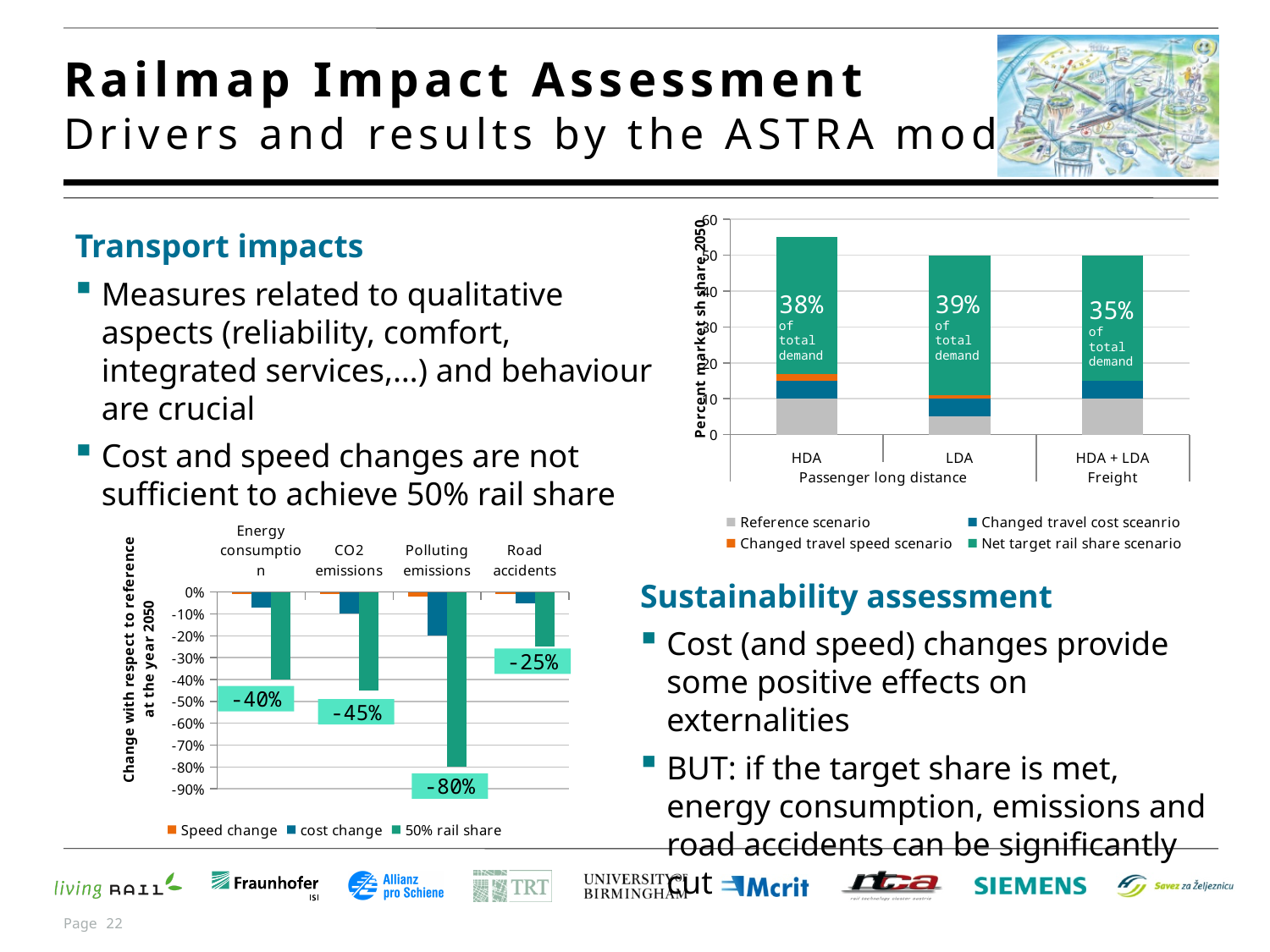
In the top-right market share chart, what share of total demand is labelled on the HDA + LDA Freight bar? 35% In the bottom-left chart, what is the value of the 50% rail share series for CO2 emissions? -45% In the top-right market share chart, what share of total demand is labelled on the LDA bar? 39% In the bottom-left chart, what is the value of the 50% rail share series for Polluting emissions? -80% How many series does the legend of the top-right market share chart list? 4 In the bottom-left chart, which category shows the smallest reduction under the 50% rail share scenario? Road accidents How many series does the legend of the bottom-left chart list? 3 In the bottom-left chart, what is the value of the 50% rail share series for Energy consumption? -40% In the bottom-left chart, what is the value of the 50% rail share series for Road accidents? -25% In the bottom-left chart, what is the difference between the 50% rail share values for Polluting emissions and Energy consumption? 40 percentage points How many categories are shown on the x axis of the bottom-left chart? 4 In the bottom-left chart, which category shows the largest reduction under the 50% rail share scenario? Polluting emissions